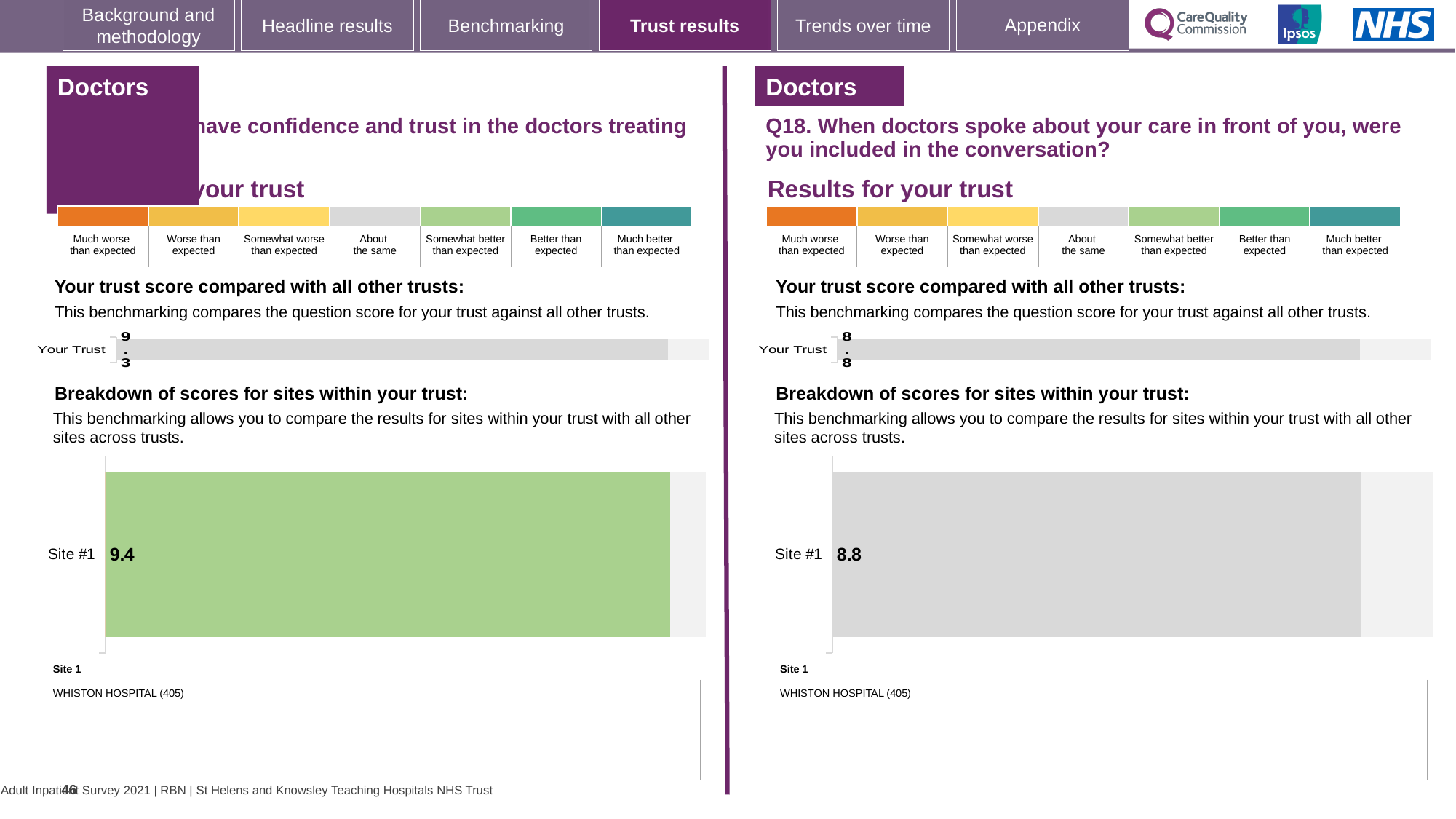
Which hospital is listed as Site 1 beneath the Q18 site breakdown chart on the right half of the slide? WHISTON HOSPITAL (405) What is the difference between the Site #1 score on the left half of the slide (9.4) and the Site #1 score on the right half (8.8)? 0.6 Which is larger: the Site #1 score in the left-hand site breakdown chart or the Site #1 score in the right-hand (Q18) site breakdown chart? Left-hand chart (9.4) On the left half of the slide, what score is shown for Site #1 in the breakdown of scores for sites chart? 9.4 On the left half of the slide, what is the 'Your Trust' score shown in the trust benchmarking bar chart? 9.3 What type of chart is used to show the Site #1 score on the left half of the slide? Bar chart In the Q18 site breakdown chart on the right half of the slide, is the Site #1 score greater or less than 9? less In the Q18 site breakdown chart on the right half of the slide, what score is shown for Site #1? 8.8 What colour is the Site #1 bar in the site breakdown chart on the left half of the slide? Green What is the difference between the 'Your Trust' score on the left half of the slide and the 'Your Trust' score for Q18 on the right half? 0.5 In the Q18 chart on the right half of the slide, what is the 'Your Trust' score? 8.8 How many sites are shown in the Q18 site breakdown chart on the right half of the slide? 1